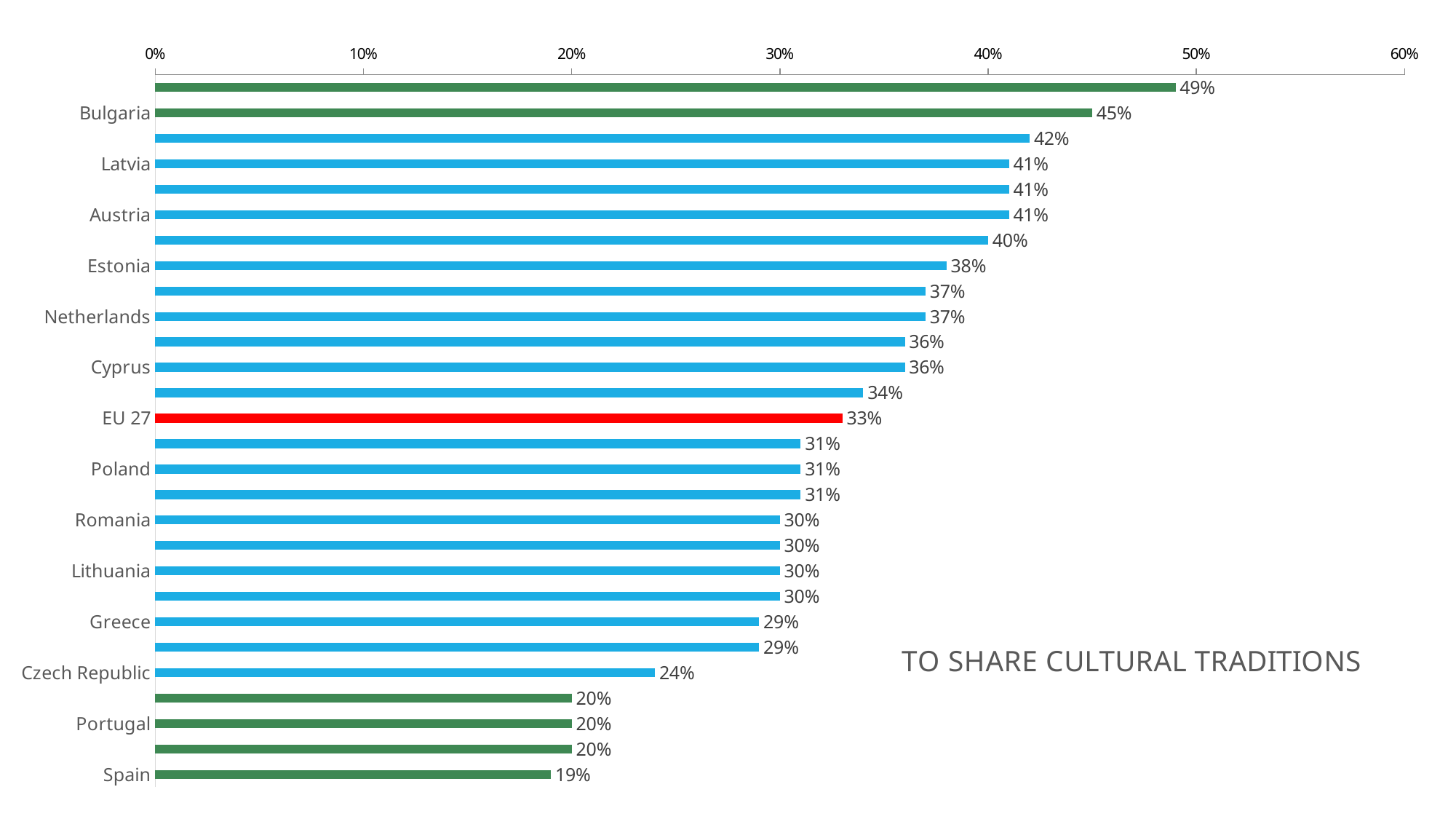
What is the difference between the values for Netherlands and EU 27? 4% Which is larger, the value for Latvia or the value for Poland? Latvia Is the value for Greece greater or less than 30%? less How many bars are plotted in the chart? 28 What is the value for Bulgaria? 45% What is the title text shown on the chart? TO SHARE CULTURAL TRADITIONS What is the value for EU 27? 33% Which labelled category has the lowest value? Spain What kind of chart is shown on the slide? Bar chart What is the value for Estonia? 38% What is the value for Czech Republic? 24% What is the difference between the values for Bulgaria and Spain? 26%